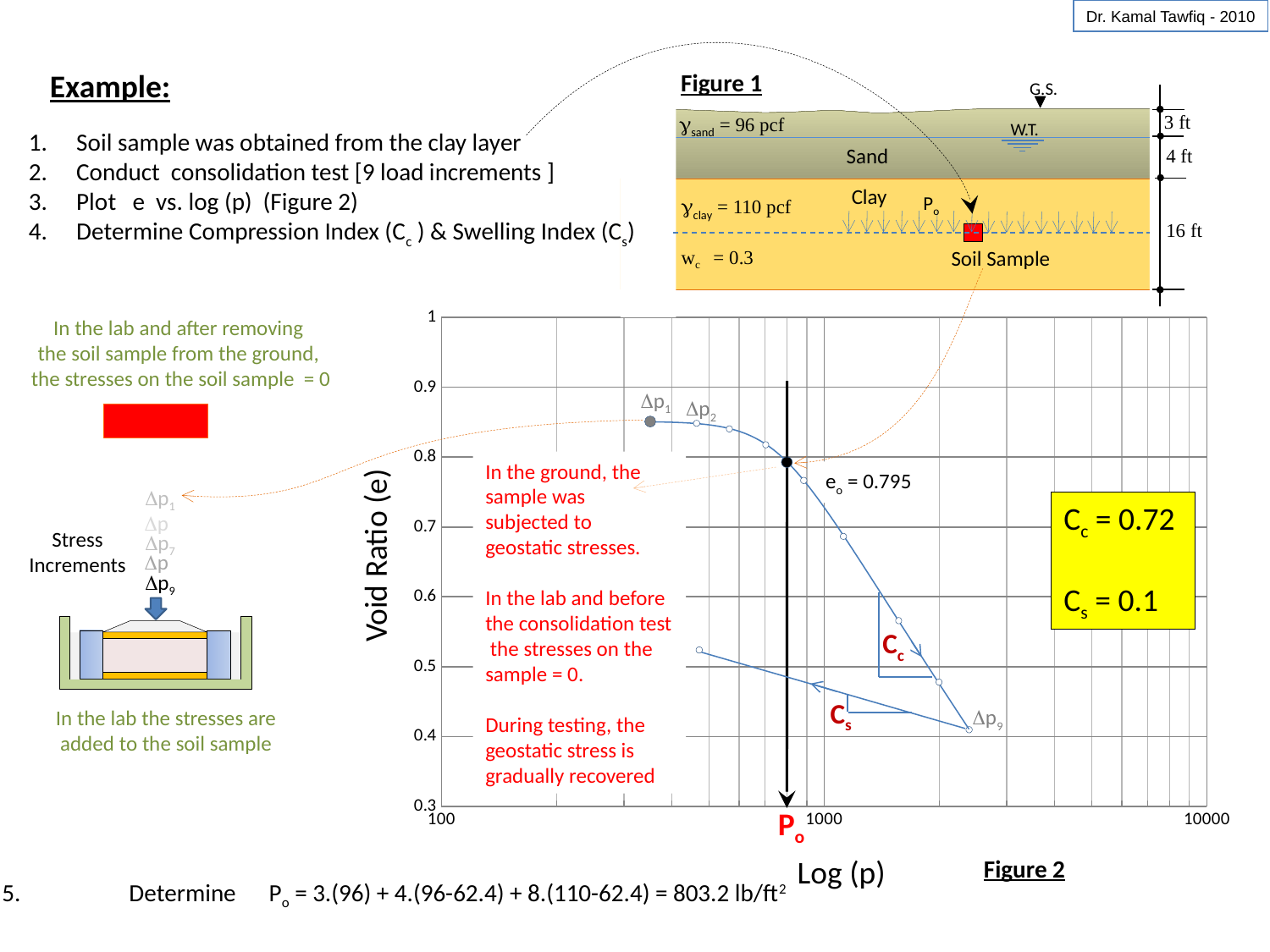
Which is larger, the Compression Index C_c or the Swelling Index C_s? C_c In Figure 2, what is the Compression Index C_c shown in the yellow box? 0.72 In Figure 2, what is the value of the initial void ratio e_o marked at P_o? 0.795 What is the label of the vertical axis in Figure 2? Void Ratio (e) How many load increments were applied in the consolidation test plotted in Figure 2? 9 What is the computed value of P_o given at the bottom of the slide? 803.2 lb/ft² What is the difference between C_c and C_s? 0.62 What kind of chart is Figure 2? line chart In Figure 2, what is the Swelling Index C_s shown in the yellow box? 0.1 In Figure 2, is the void ratio at the point labelled Δp9 greater or less than 0.5? less In Figure 2, does the void ratio rise or fall along the loading curve as p increases? fall In Figure 2, is the void ratio at the point labelled Δp1 greater or less than 0.8? greater